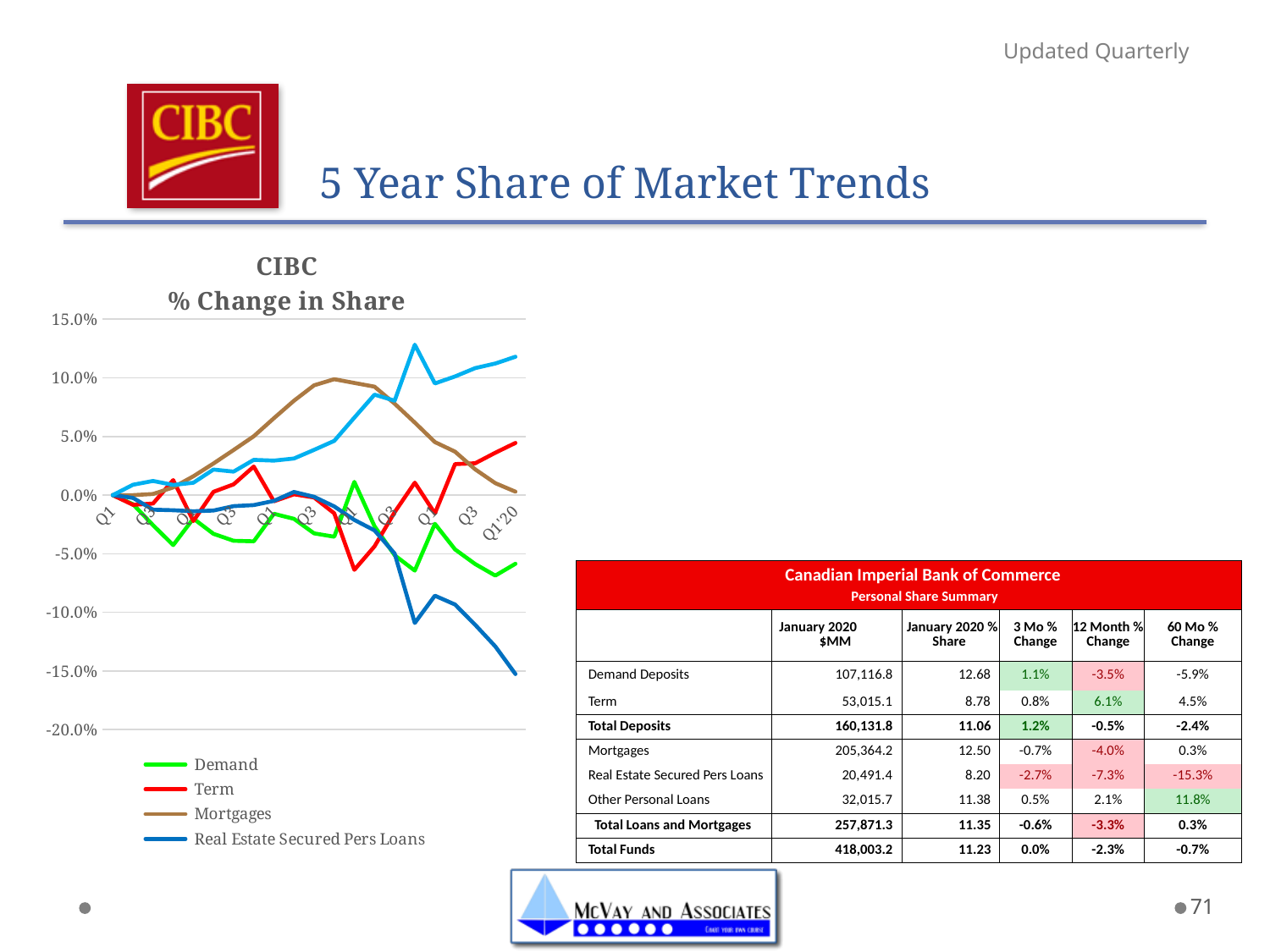
Does the Term line rise or fall over the last few points leading to Q1'20? rise Which legend series has the lowest value at Q1'20? Real Estate Secured Pers Loans Does the Real Estate Secured Pers Loans line rise or fall overall from the first point to Q1'20? fall What kind of chart is shown on the slide? line chart At Q1'20, which is higher: Term or Mortgages? Term How many series does the legend of the chart list? 4 Is the value for Term at Q1'20 greater or less than 0.0%? greater What is the highest value shown on the vertical axis? 15.0% Is the value for Real Estate Secured Pers Loans at Q1'20 greater or less than -10.0%? less What is the title of the chart? CIBC % Change in Share Is the value for Demand at Q1'20 greater or less than 0.0%? less Which series in the legend is drawn in green? Demand